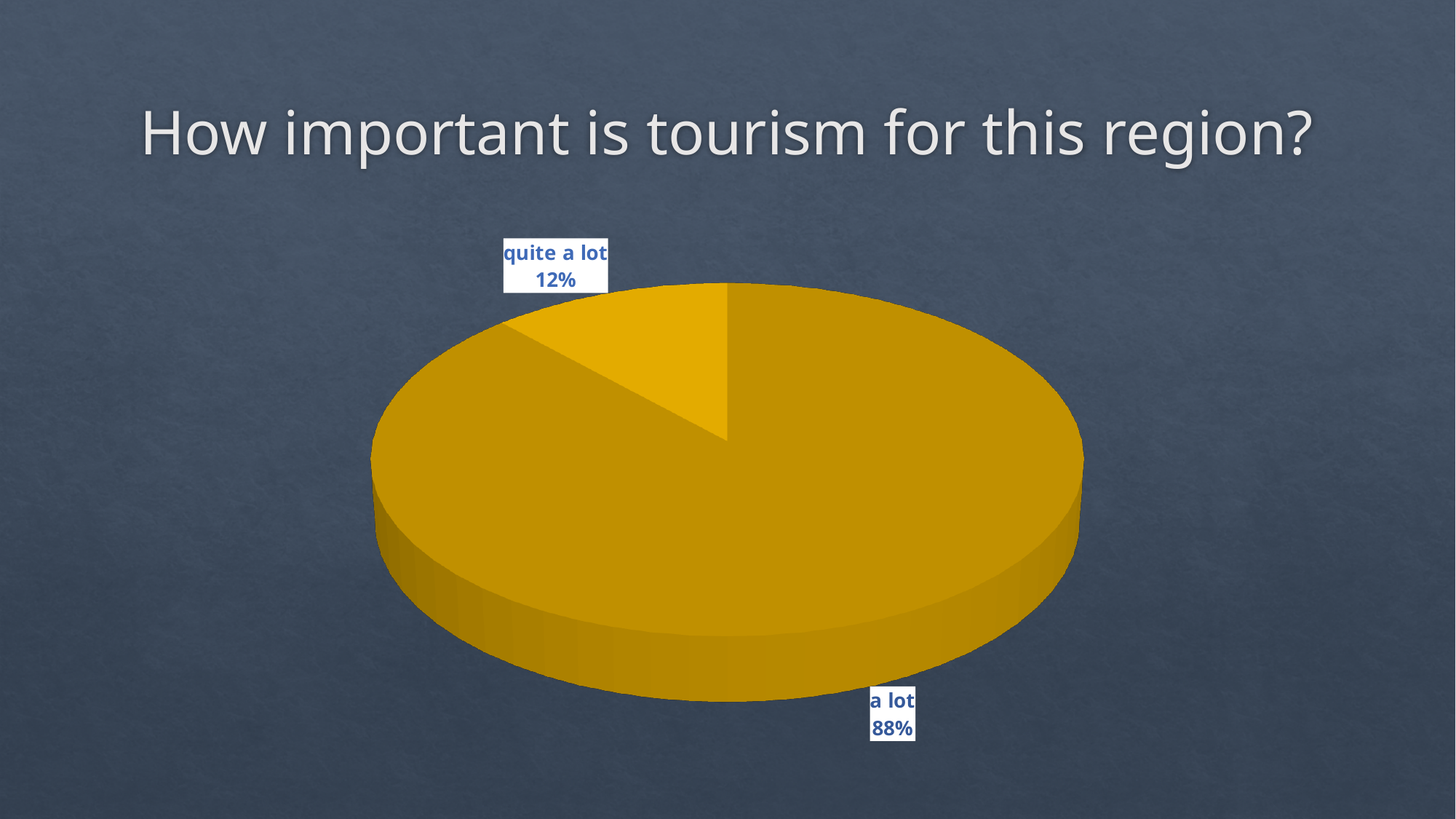
How many categories are shown in the pie chart? 2 Which category has the smallest slice of the pie? quite a lot What kind of chart is shown on the slide? pie chart What is the difference in percentage points between "a lot" and "quite a lot"? 76 What is the total of the two percentages shown on the pie chart? 100% Which is larger, the slice for "a lot" or the slice for "quite a lot"? a lot What share of the pie does "a lot" represent? 88% What share of the pie does "quite a lot" represent? 12% Which category has the largest slice of the pie? a lot What is the title of the slide? How important is tourism for this region?